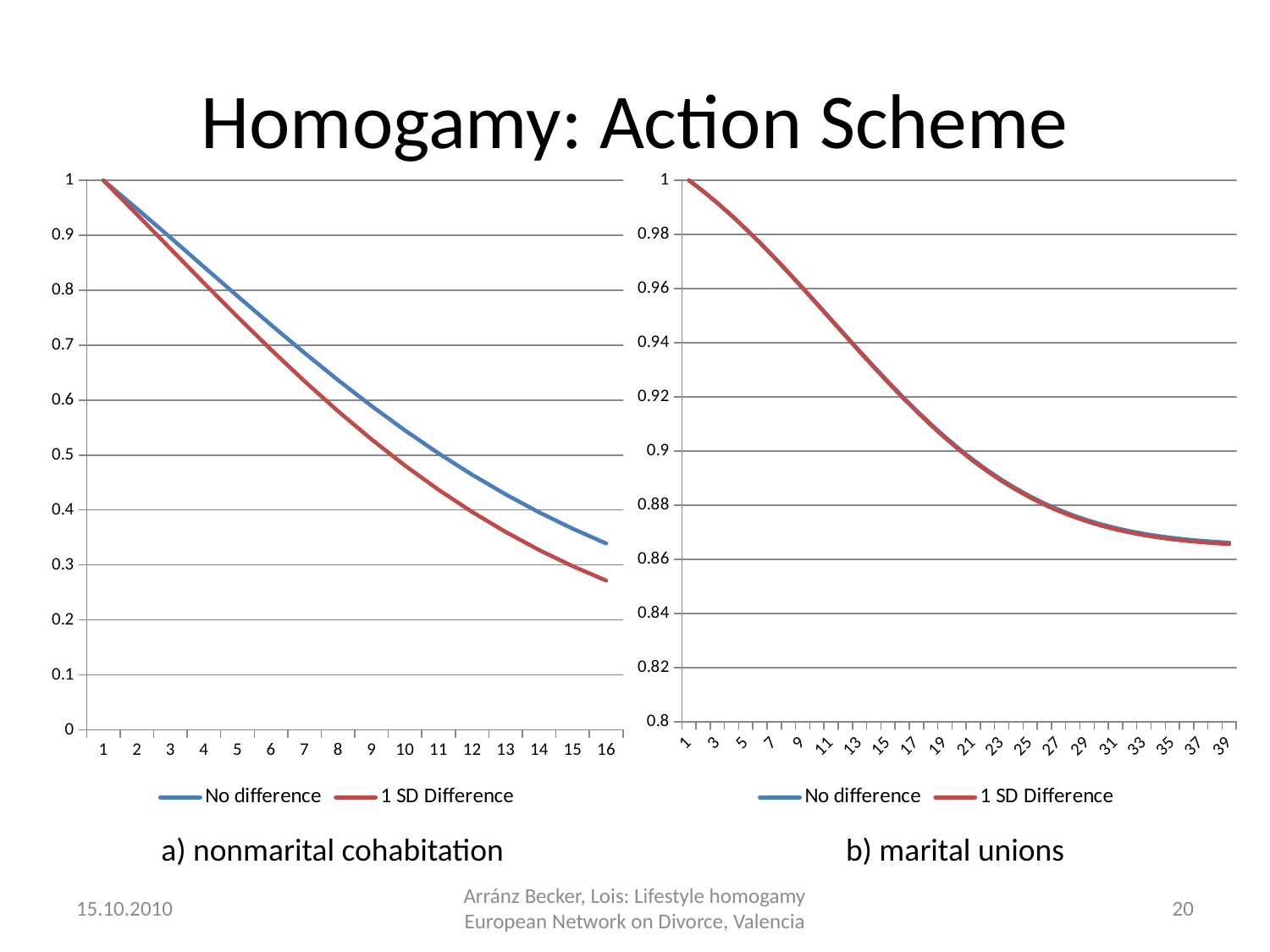
In the chart labelled b) marital unions, is the value of the No difference series at x = 39 greater or less than 0.88? less In the chart labelled a) nonmarital cohabitation, is the value of the No difference series at x = 6 greater or less than 0.7? greater Which colour is used for the 1 SD Difference series in the chart labelled b) marital unions? red In the chart labelled a) nonmarital cohabitation, how many points are on the x axis? 16 In the chart labelled a) nonmarital cohabitation, is the value of the 1 SD Difference series at x = 16 greater or less than 0.3? less In the chart labelled a) nonmarital cohabitation, at x = 16, which series has the larger value, No difference or 1 SD Difference? No difference How many series does the legend of the chart labelled b) marital unions list? 2 What kind of chart is the chart labelled a) nonmarital cohabitation? line chart In the chart labelled a) nonmarital cohabitation, what is the value of the No difference series at x = 1? 1 In the chart labelled b) marital unions, do the values of the 1 SD Difference series rise or fall along the x axis? fall In the chart labelled a) nonmarital cohabitation, do the values of the No difference series rise or fall along the x axis? fall In the chart labelled b) marital unions, what is the last x-axis label? 39